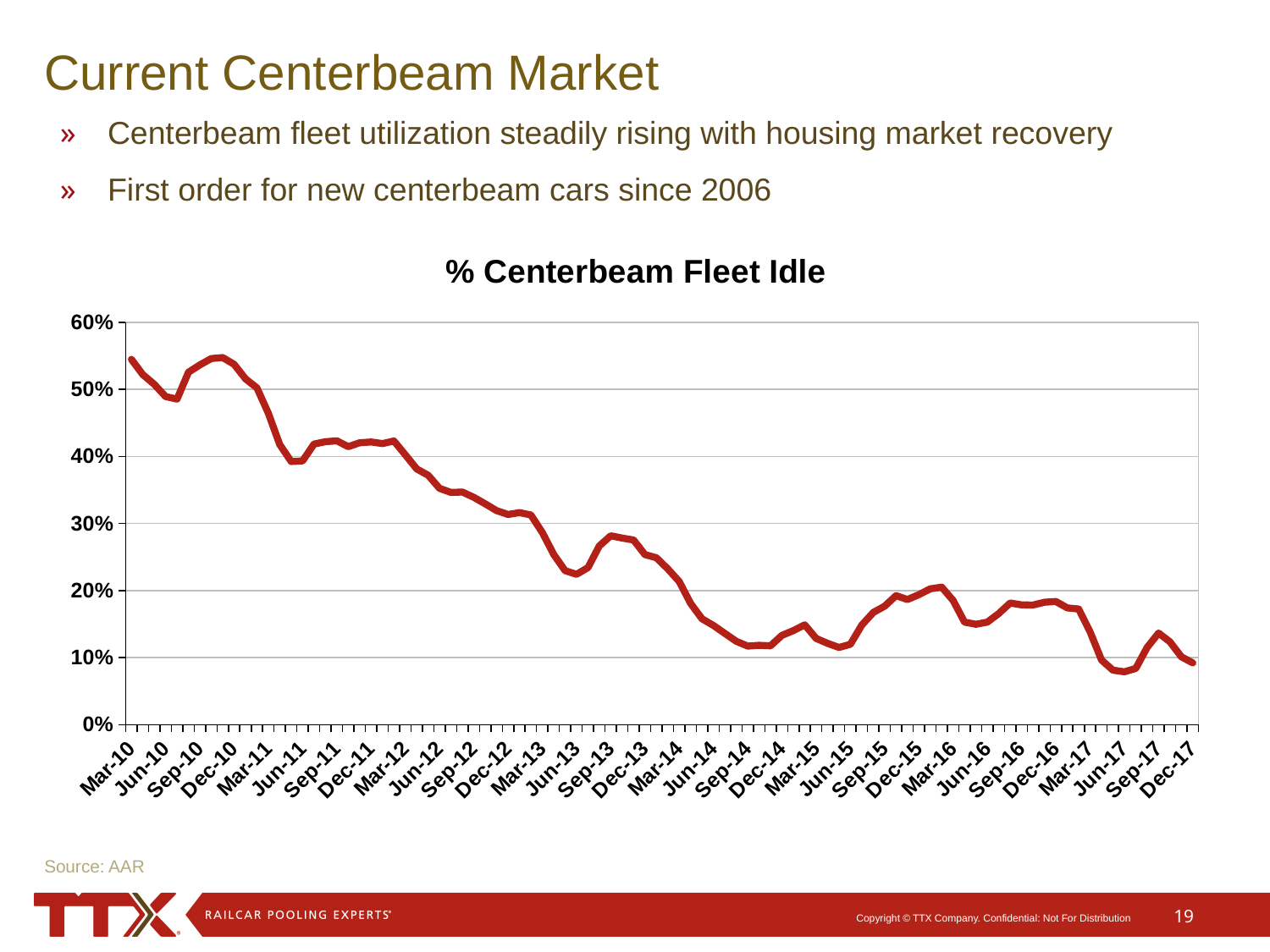
Is the value for Sep-13 greater or less than 30%? less Is the value for Jun-10 greater or less than 50%? less How many date labels are shown on the x axis? 32 Is the value for Jun-12 greater or less than 30%? greater Overall, do the values rise or fall from Mar-10 to Dec-17? fall What is the title of the chart? % Centerbeam Fleet Idle What kind of chart is shown on the slide? line chart Which is larger, the value for Mar-10 or the value for Dec-17? Mar-10